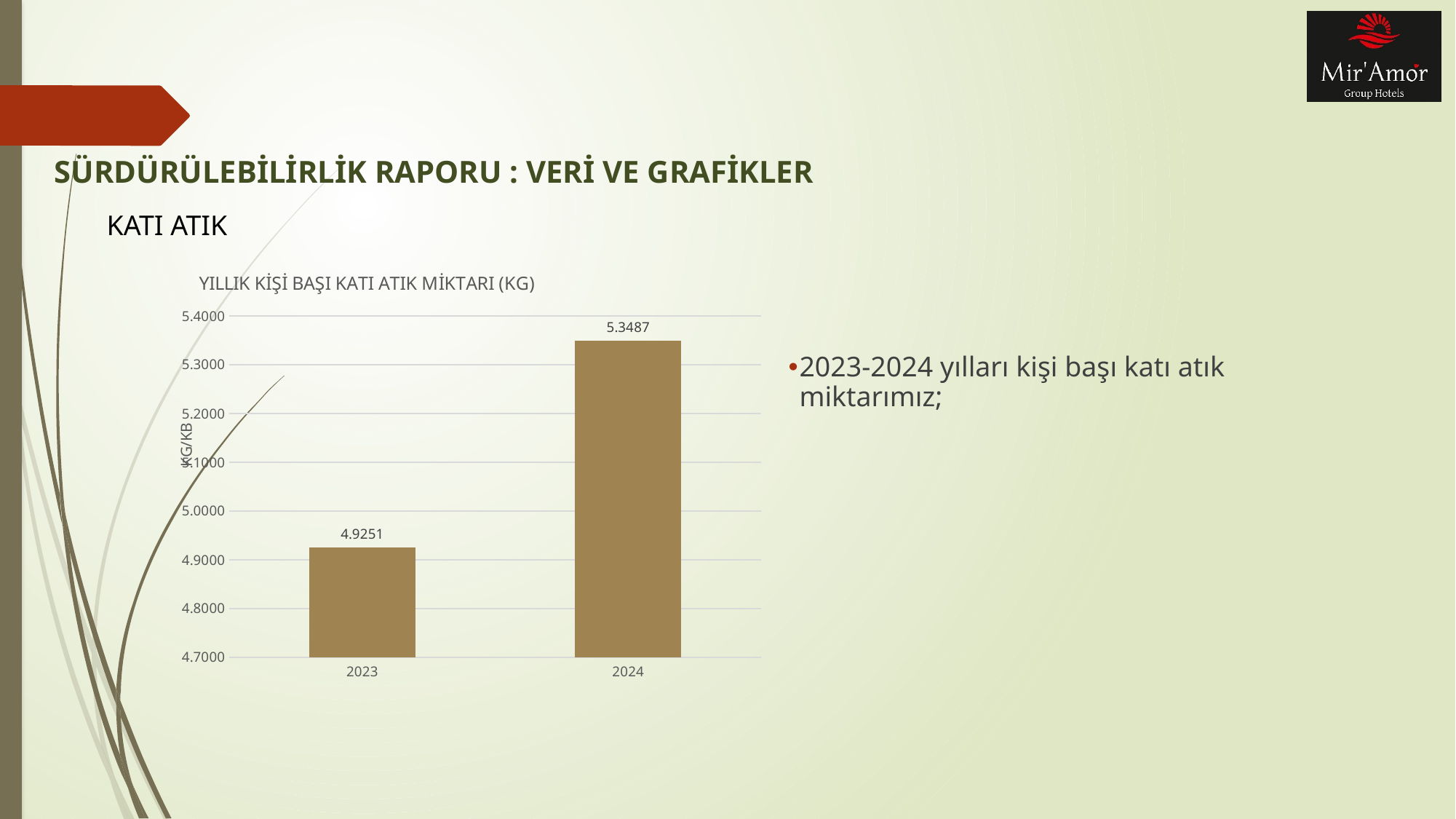
Is the value for 2024 greater or less than 5.3000? greater Which year has the highest value in the chart? 2024 Do the values rise or fall from 2023 to 2024? Rise What is the difference between the 2024 and 2023 values? 0.4236 What is the value for 2024 in the chart? 5.3487 What is the title of the chart? YILLIK KİŞİ BAŞI KATI ATIK MİKTARI (KG) What is the value for 2023 in the chart? 4.9251 Which year has the lowest value in the chart? 2023 What kind of chart is shown on the slide? Bar chart How many bars are shown in the chart? 2 Is the value for 2023 greater or less than 5.0000? less Which is larger, the value for 2023 or the value for 2024? 2024